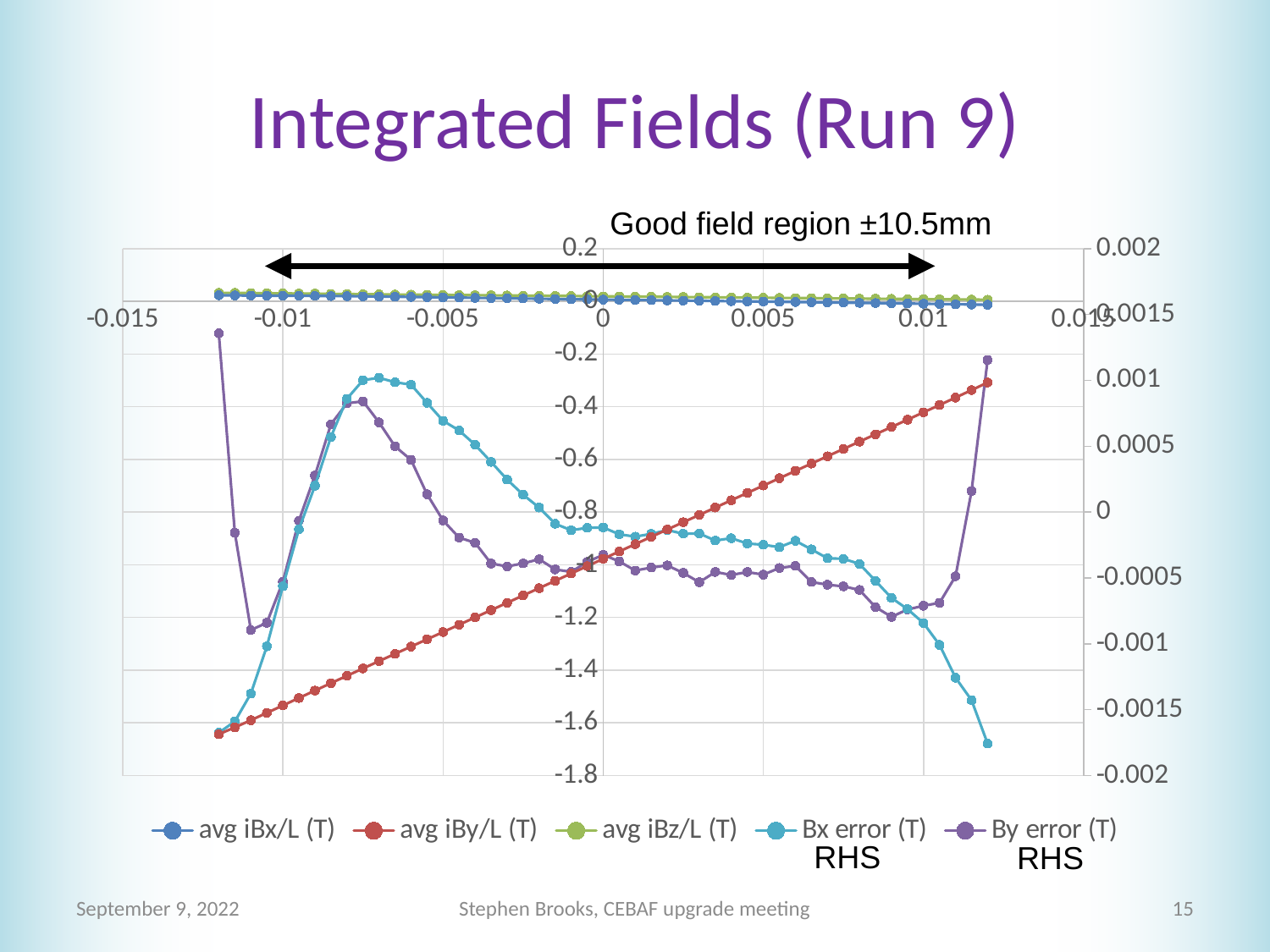
What good field region is annotated above the chart? ±10.5mm What is the lowest value shown on the left vertical axis? -1.8 Does the avg iBy/L (T) series rise or fall as x increases from -0.012 to 0.012? rise Is the value of Bx error (T) at x = 0.012 greater or less than -0.0015 on the right axis? less What is the title of the chart? Integrated Fields (Run 9) What kind of chart is shown on the slide? line chart Is the value of Bx error (T) at x = 0 greater or less than 0 on the right axis? less Is the value of By error (T) at x = -0.012 greater or less than 0.001 on the right axis? greater How many series does the legend list? 5 At x = -0.012, which is larger on the left axis: avg iBy/L (T) or avg iBx/L (T)? avg iBx/L (T)